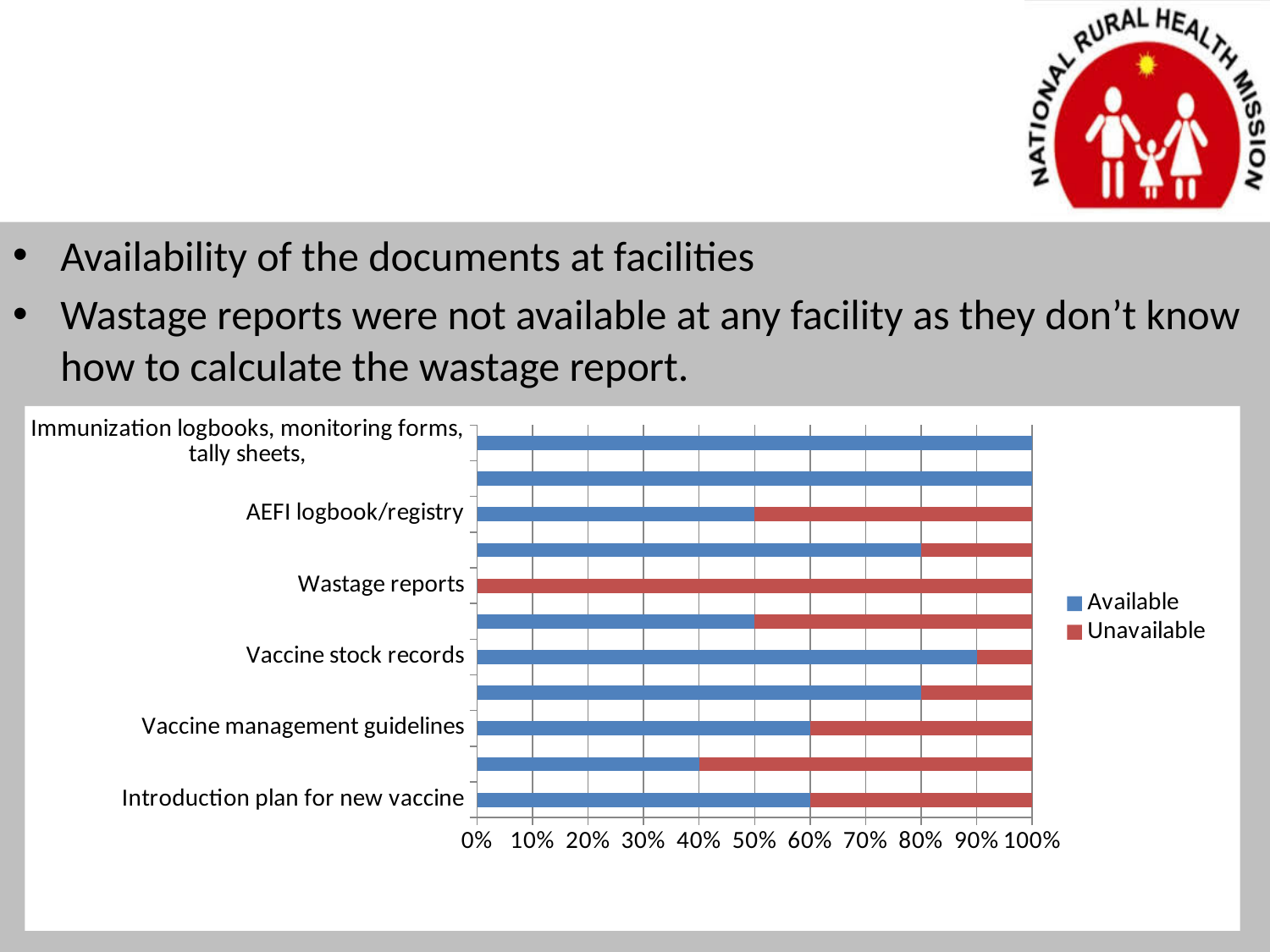
What are the two series named in the chart legend? Available and Unavailable What is the Unavailable value for Wastage reports? 100% Which labelled document has the lowest Available value? Wastage reports Which has a larger Available value, Vaccine stock records or AEFI logbook/registry? Vaccine stock records What is the Available value for Immunization logbooks, monitoring forms, tally sheets? 100% How many series does the chart legend list? 2 What kind of chart is shown on the slide? bar chart What is the Available value for Vaccine stock records? 90% What colour represents the Available series in the chart? blue Is the Available value for Vaccine management guidelines greater or less than 50%? greater What is the Available value for AEFI logbook/registry? 50% What is the Available value for Wastage reports? 0%